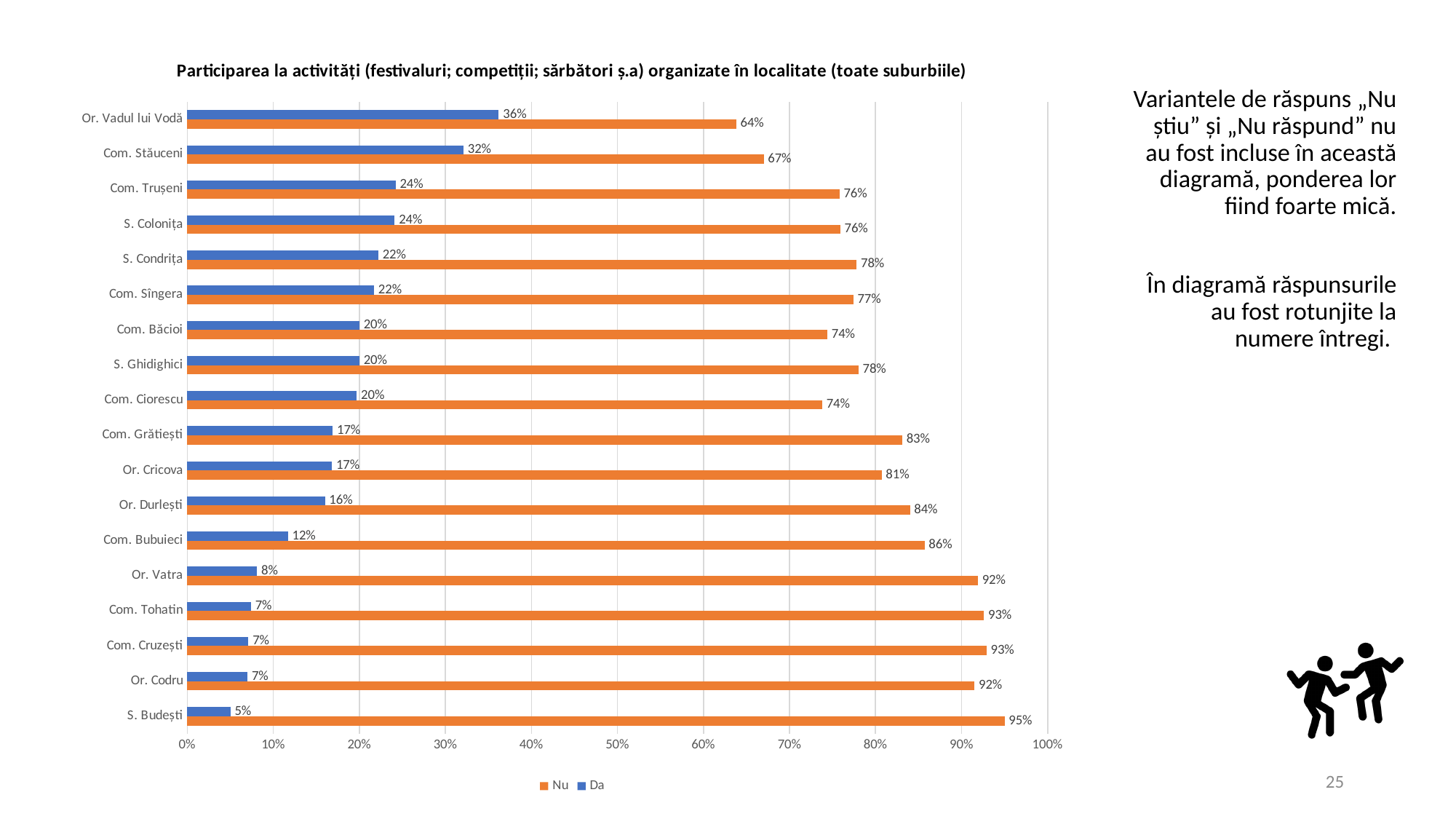
Which is larger: the "Da" value for Com. Stăuceni or the "Da" value for Com. Trușeni? Com. Stăuceni How many series does the legend list? 2 What is the "Nu" value for Com. Stăuceni? 67% What kind of chart is shown on the slide? Bar chart What is the "Da" value for Or. Vadul lui Vodă? 36% Which locality has the highest "Nu" value? S. Budești Which colour represents the "Nu" series? Orange What is the difference between the "Nu" and "Da" values for Or. Durlești? 68% How many localities are shown on the chart? 18 What is the "Nu" value for Com. Bubuieci? 86% Is the "Nu" value for Or. Vatra greater or less than 90%? greater Which locality has the lowest "Da" value? S. Budești